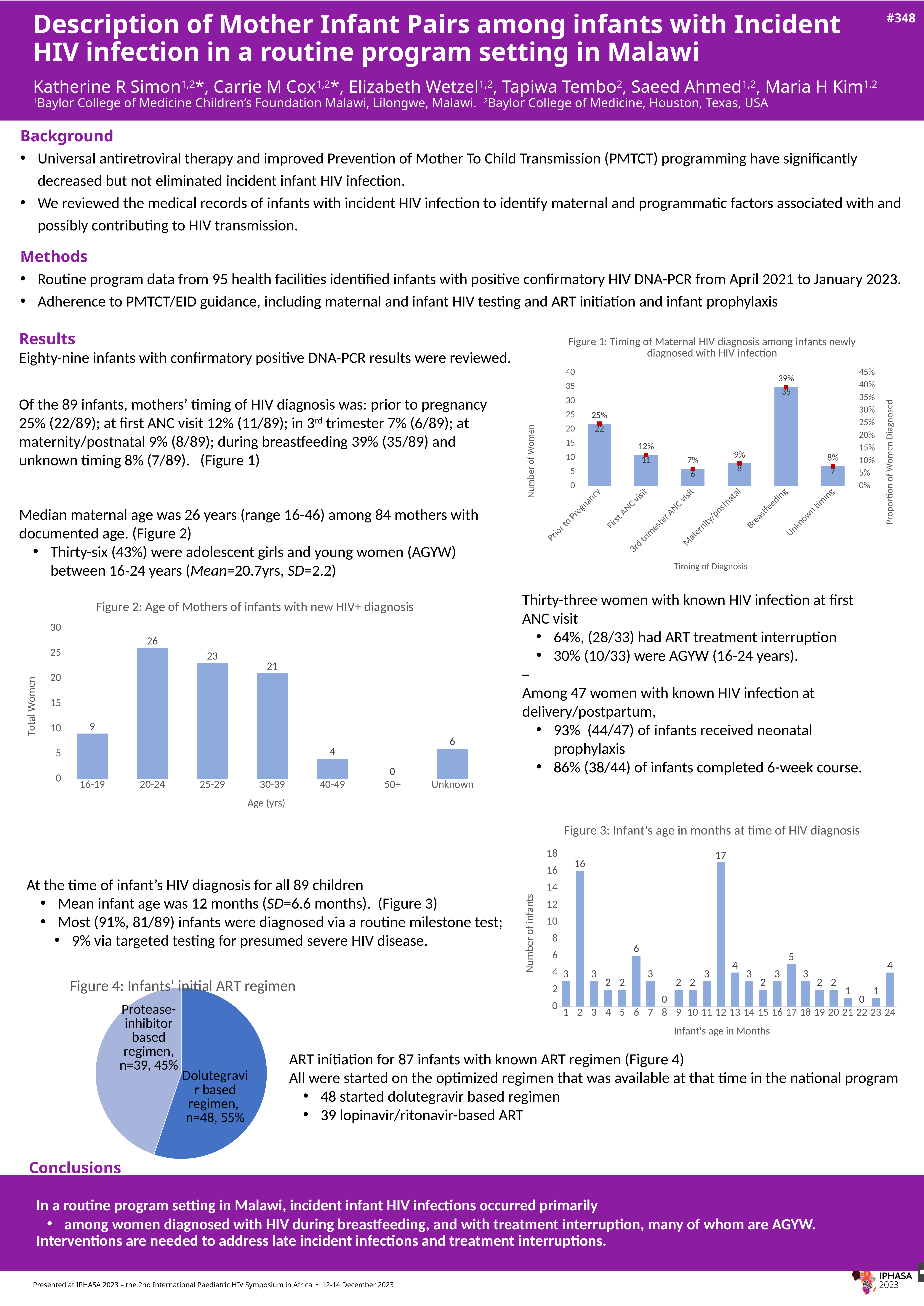
In Figure 1 (Timing of Maternal HIV diagnosis), how many women were diagnosed during breastfeeding? 35 In Figure 2 (Age of Mothers), how many age categories are shown on the x axis? 7 In Figure 1 (Timing of Maternal HIV diagnosis), what is the difference in number of women between Breastfeeding and Prior to Pregnancy? 13 In Figure 2 (Age of Mothers), which is larger, the value for 16-19 or the value for Unknown? 16-19 In Figure 1 (Timing of Maternal HIV diagnosis), what percentage of women were diagnosed prior to pregnancy? 25% In Figure 3 (Infant's age in months at time of HIV diagnosis), at which age in months is the number of infants highest? 12 In Figure 1 (Timing of Maternal HIV diagnosis), which timing of diagnosis has the lowest number of women? 3rd trimester ANC visit What kind of chart is Figure 4 (Infants' initial ART regimen)? Pie chart In Figure 2 (Age of Mothers), how many women are in the 30-39 age group? 21 In Figure 4 (Infants' initial ART regimen), what share of infants started a dolutegravir based regimen? 55% In Figure 3 (Infant's age in months at time of HIV diagnosis), how many infants were diagnosed at 2 months? 16 In Figure 2 (Age of Mothers), which age group has the highest number of women? 20-24